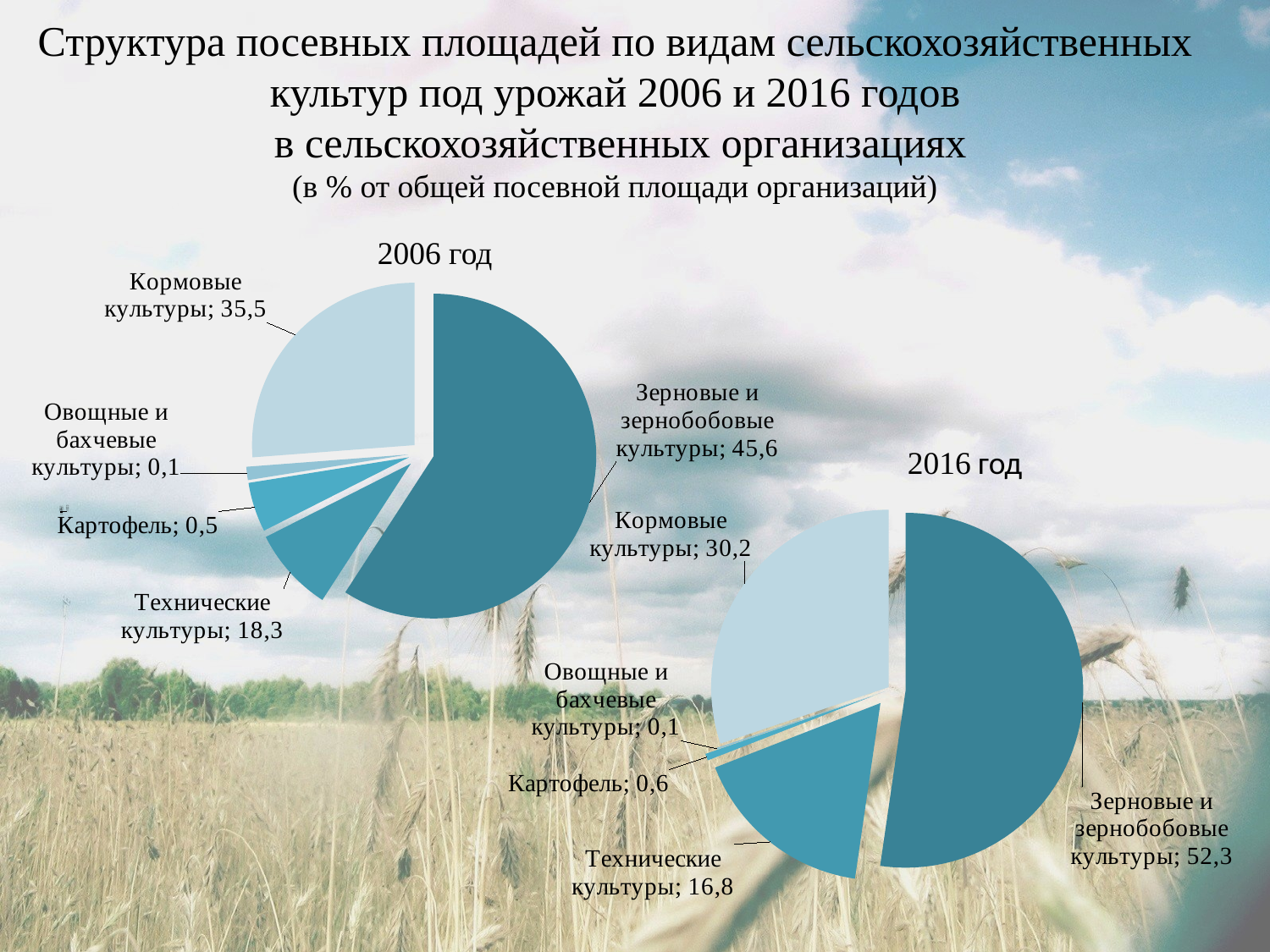
What is the difference between the value for Зерновые и зернобобовые культуры in the 2016 год chart and in the 2006 год chart? 6,7 In the 2016 год pie chart, what is the value for Кормовые культуры? 30,2 In the 2006 год pie chart, what is the value for Зерновые и зернобобовые культуры? 45,6 In the 2006 год pie chart, which category has the smallest share? Овощные и бахчевые культуры In the 2006 год pie chart, what is the value for Технические культуры? 18,3 In the 2016 год pie chart, what is the value for Картофель? 0,6 Which is larger: Технические культуры in the 2006 год chart or in the 2016 год chart? 2006 год What type of chart is used for the 2006 год data? Pie chart In the 2016 год pie chart, which category has the largest share? Зерновые и зернобобовые культуры How many pie charts are shown on the slide? 2 In the 2006 год pie chart, what is the difference between Кормовые культуры and Технические культуры? 17,2 How many categories does the 2016 год pie chart show? 5